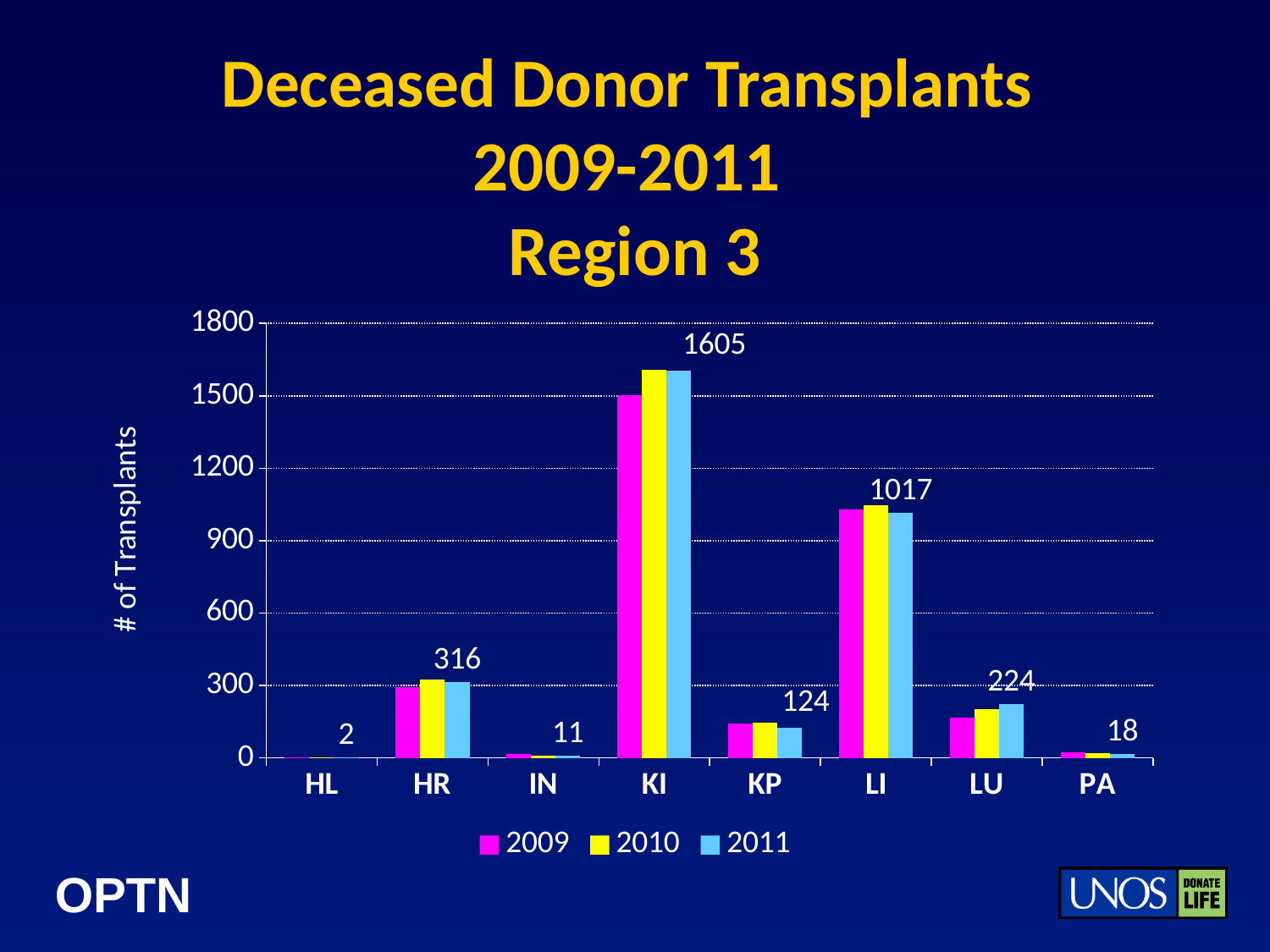
Is the 2009 value for LU greater or less than 300? less What kind of chart is shown? bar chart Which category has the lowest number of transplants? HL What is the 2011 value for LI? 1017 Which category has the highest number of transplants? KI How many series does the legend list? 3 Which has a larger 2011 value, LU or KP? LU What is the difference between the 2011 values for KI and LI? 588 What is the 2011 value for KI? 1605 Is the 2009 value for KI greater or less than 1200? greater How many categories are shown on the x axis? 8 What is the 2011 value for HR? 316